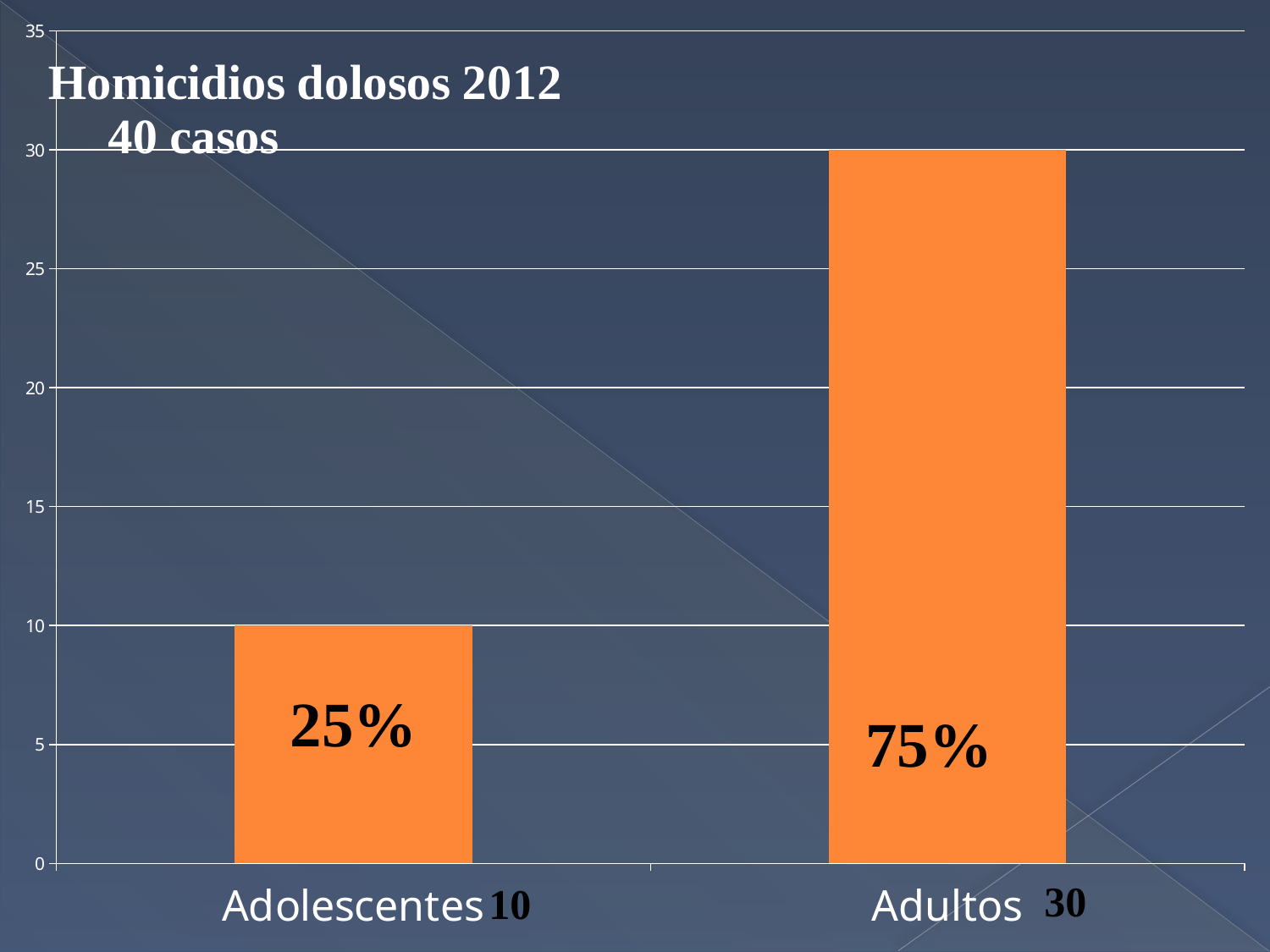
Is the value for Adultos greater or less than 25? greater What percentage is shown on the Adolescentes bar? 25% Which is larger, the value for Adolescentes or the value for Adultos? Adultos What kind of chart is shown on the slide? bar chart How many categories are shown in the chart? 2 Which category has the highest value? Adultos Which category has the lowest value? Adolescentes What is the difference between the values for Adultos and Adolescentes? 20 What is the title of the chart? Homicidios dolosos 2012 40 casos What percentage is shown on the Adultos bar? 75% What is the value for Adultos? 30 What is the value for Adolescentes? 10